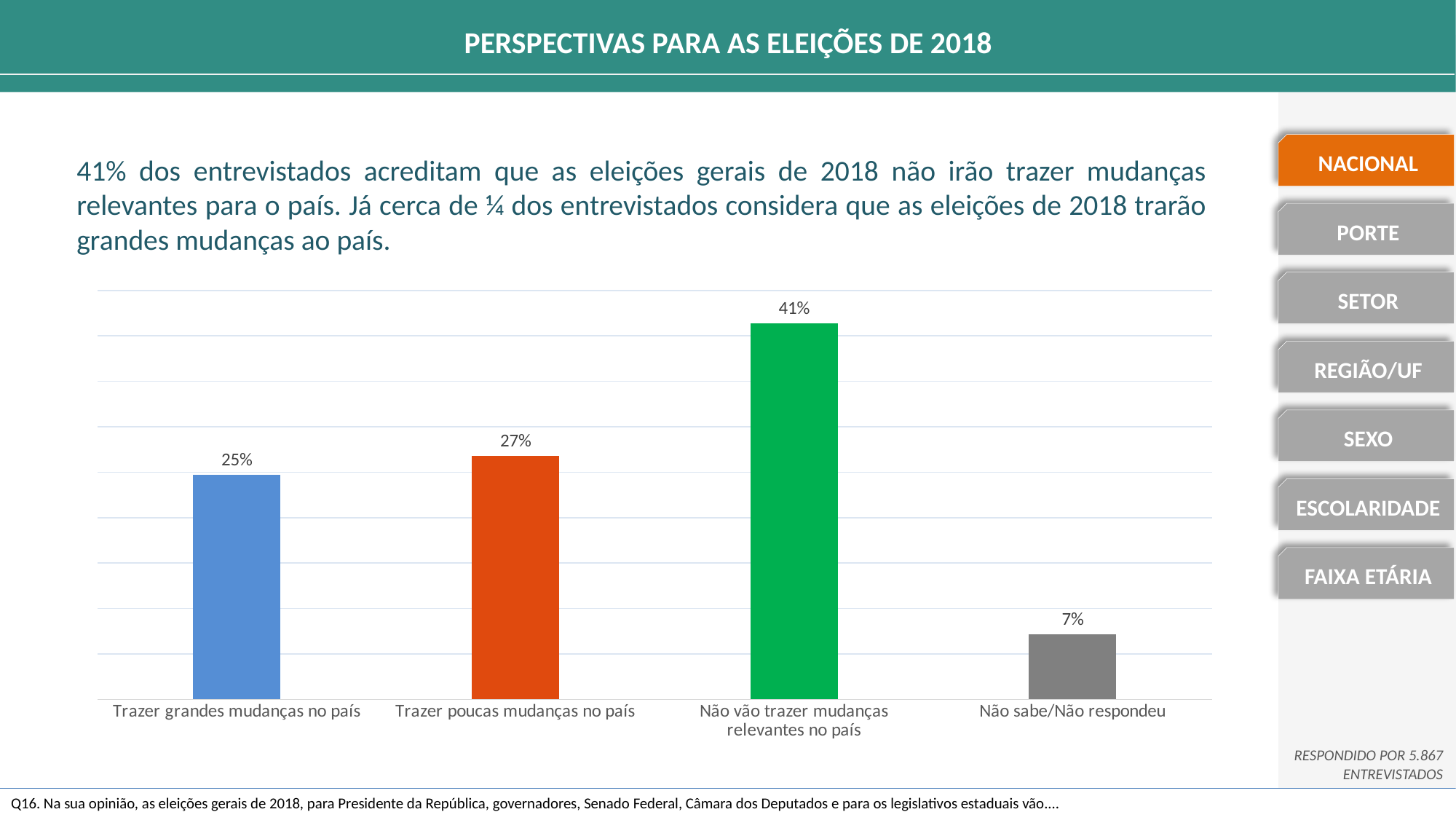
Which category has the highest value? Não vão trazer mudanças relevantes no país What is the difference between "Trazer poucas mudanças no país" and "Não sabe/Não respondeu"? 20% What is the value for "Trazer grandes mudanças no país"? 25% What kind of chart is shown on the slide? Bar chart What is the value for "Não vão trazer mudanças relevantes no país"? 41% What is the value for "Não sabe/Não respondeu"? 7% What colour is the bar for "Não vão trazer mudanças relevantes no país"? Green Which category has the lowest value? Não sabe/Não respondeu Which is larger: "Trazer poucas mudanças no país" or "Trazer grandes mudanças no país"? Trazer poucas mudanças no país What is the difference between "Não vão trazer mudanças relevantes no país" and "Trazer grandes mudanças no país"? 16% What is the value for "Trazer poucas mudanças no país"? 27% How many categories are shown in the chart? 4